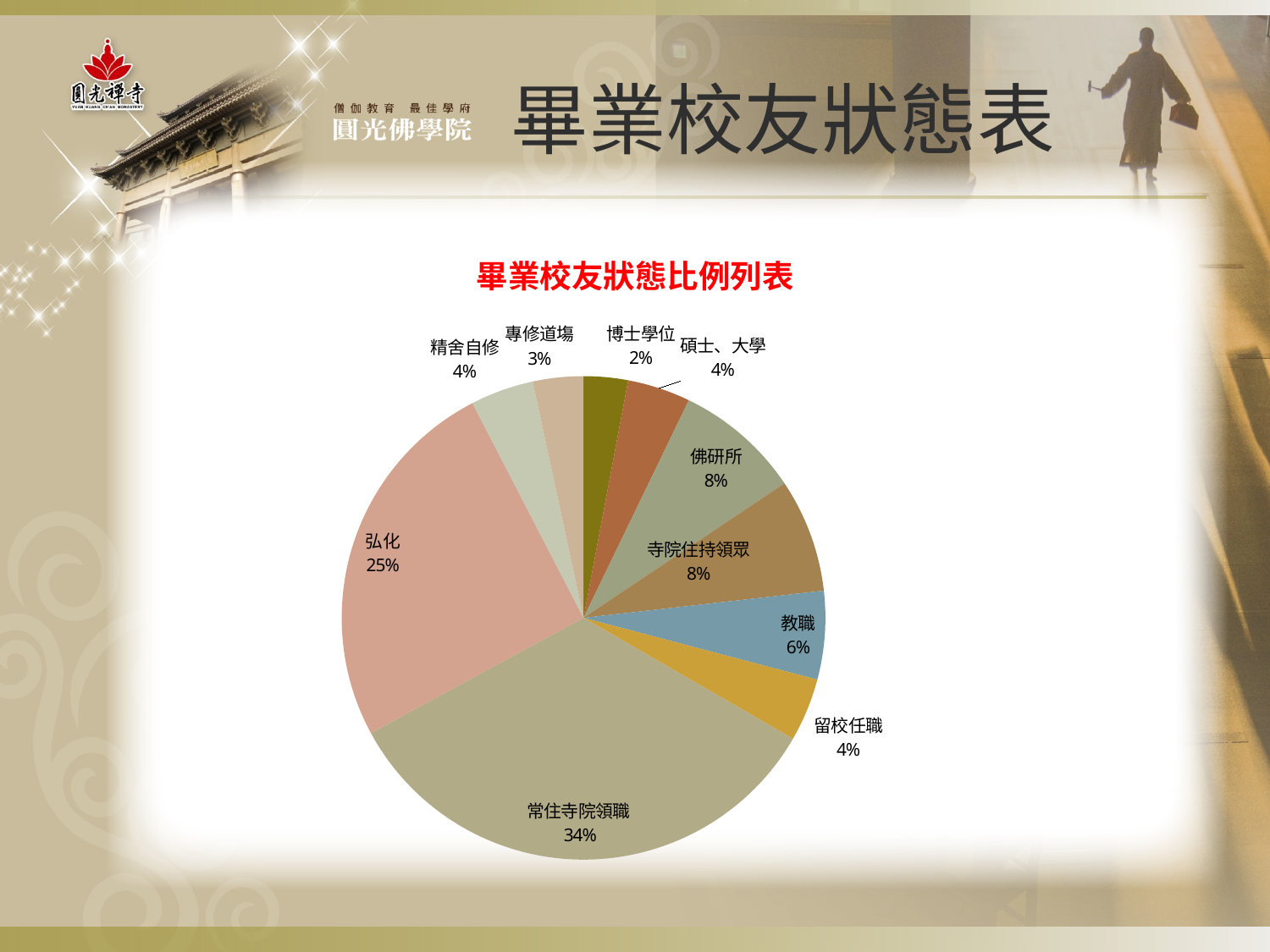
What percentage of the pie is 教職? 6% What percentage of the pie is 專修道場? 3% Which category has the largest share of the pie? 常住寺院領職 How many categories (slices) does the pie chart have? 10 What percentage of the pie is 弘化? 25% What percentage of the pie is 博士學位? 2% Which category has the smallest share of the pie? 博士學位 What is the difference in percentage points between 常住寺院領職 and 弘化? 9 Which is larger, the share for 佛研所 or the share for 教職? 佛研所 What percentage of the pie is 常住寺院領職? 34% What kind of chart is shown on the slide? pie chart What is the title of the chart? 畢業校友狀態比例列表